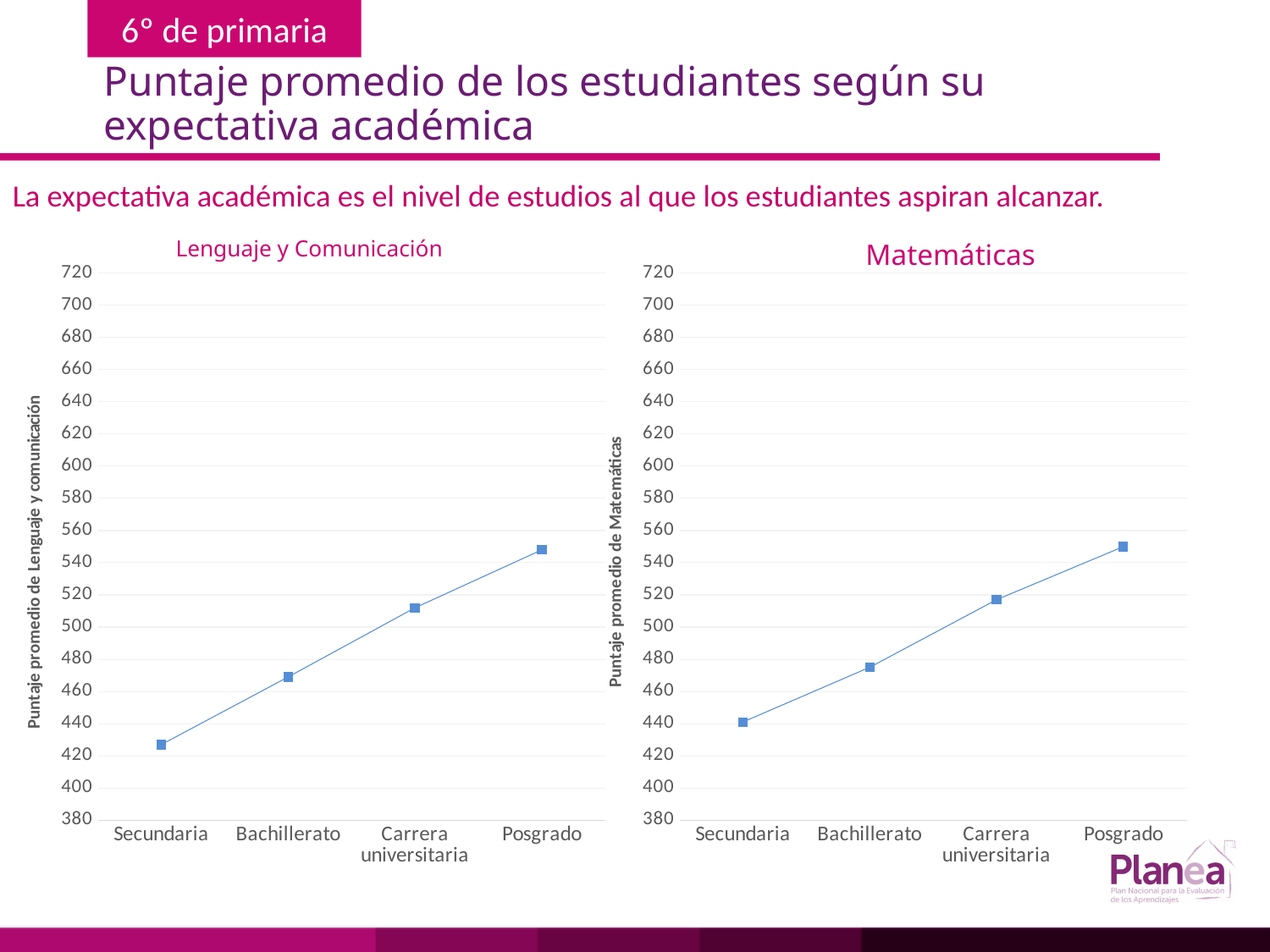
What is the title of the chart on the right side of the slide? Matemáticas What kind of chart is the Lenguaje y Comunicación chart? line chart In the Matemáticas chart, is the value for Posgrado greater or less than 560? less In the Matemáticas chart, which category has the highest average score? Posgrado In the Matemáticas chart, is the value for Carrera universitaria greater or less than 500? greater How many categories are shown on the x axis of the Matemáticas chart? 4 In the Lenguaje y Comunicación chart, which is larger, the value for Bachillerato or the value for Carrera universitaria? Carrera universitaria In the Matemáticas chart, is the value for Bachillerato greater or less than 460? greater In the Lenguaje y Comunicación chart, do the values rise or fall from Secundaria to Posgrado? rise In the Lenguaje y Comunicación chart, which category has the lowest average score? Secundaria What is the y-axis label of the Lenguaje y Comunicación chart? Puntaje promedio de Lenguaje y comunicación